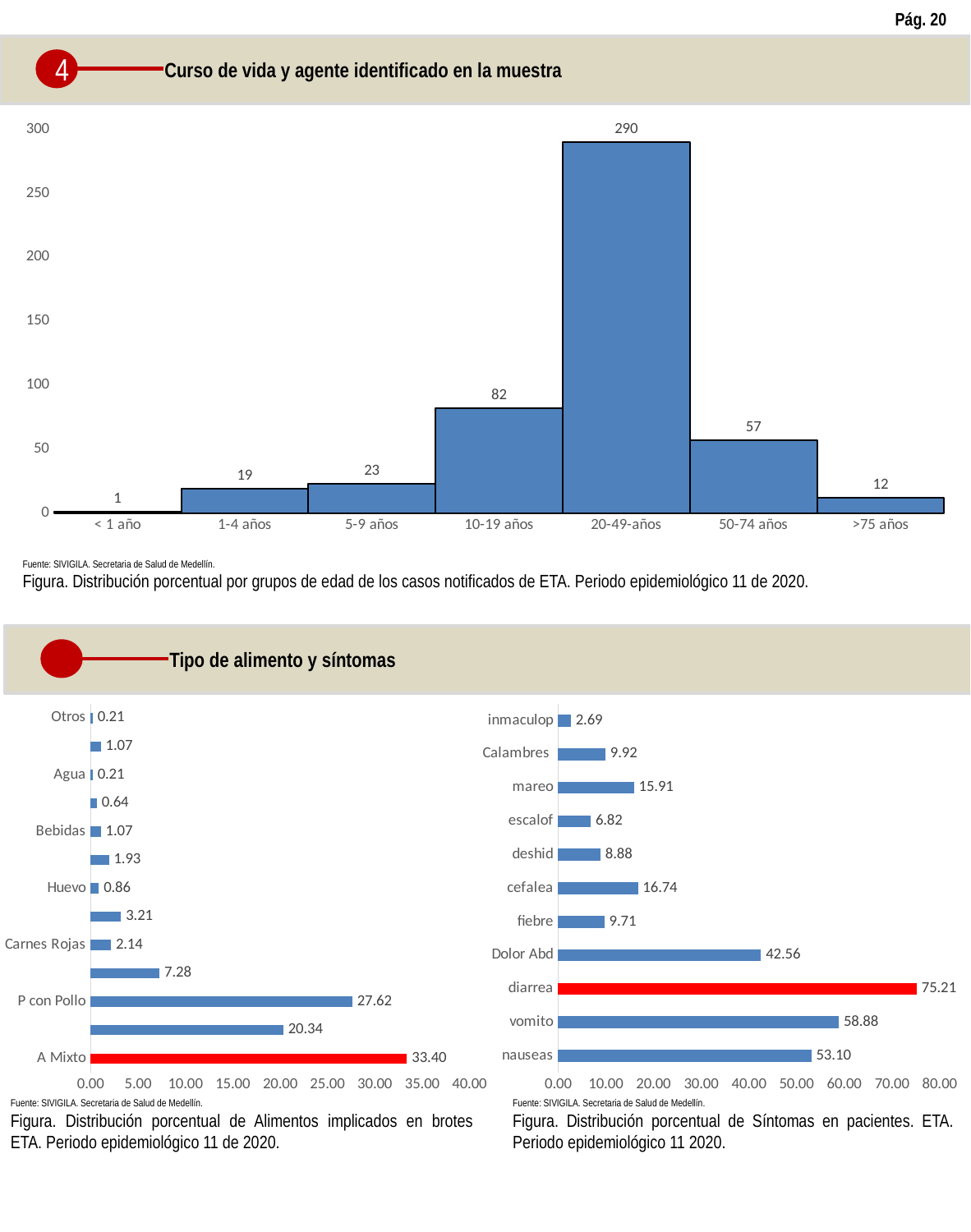
In the top chart on age groups, what is the value for 20-49-años? 290 In the bottom-right chart on symptoms (Síntomas), what is the difference between vomito and nauseas? 5.78 In the bottom-right chart on symptoms (Síntomas), what is the value for diarrea? 75.21 In the top chart on age groups, which is larger, the value for 1-4 años or the value for >75 años? 1-4 años In the bottom-left chart on foods (Alimentos), which labelled category has the highest value? A Mixto In the top chart on age groups, which age group has the lowest value? < 1 año In the bottom-right chart on symptoms (Síntomas), which symptom has the lowest value? inmaculop In the bottom-right chart on symptoms (Síntomas), how many symptoms are listed? 11 What kind of chart is the top chart on age groups? bar chart In the top chart on age groups, how many age groups are shown? 7 In the top chart on age groups, what is the difference between the values for 10-19 años and 50-74 años? 25 In the bottom-left chart on foods (Alimentos), what is the value for P con Pollo? 27.62